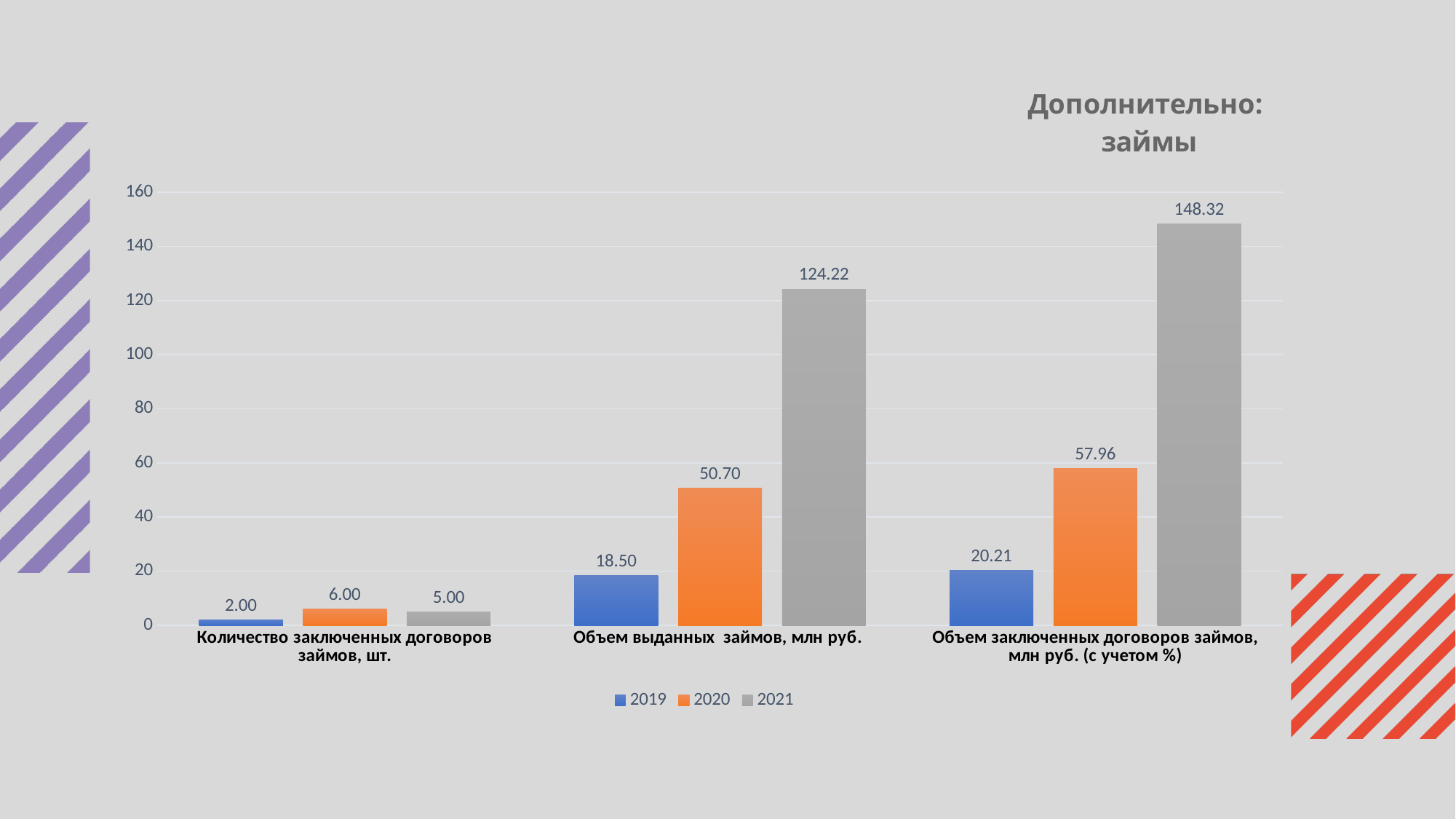
What kind of chart is shown on the slide? bar chart Which year has the highest value in the category "Объем выданных займов, млн руб."? 2021 Is the 2021 value for "Объем выданных займов, млн руб." greater or less than 120? greater What is the title of the chart? Дополнительно: займы What is the value for 2019 in the category "Количество заключенных договоров займов, шт."? 2.00 How many series does the chart legend list? 3 How many categories are shown on the x axis of the chart? 3 What is the value for 2021 in the category "Объем заключенных договоров займов, млн руб. (с учетом %)"? 148.32 What is the difference between the 2021 and 2020 values in the category "Объем заключенных договоров займов, млн руб. (с учетом %)"? 90.36 Which year has the lowest value in the category "Количество заключенных договоров займов, шт."? 2019 Which is larger in the category "Количество заключенных договоров займов, шт.": the 2020 value or the 2021 value? 2020 What is the value for 2020 in the category "Объем выданных займов, млн руб."? 50.70